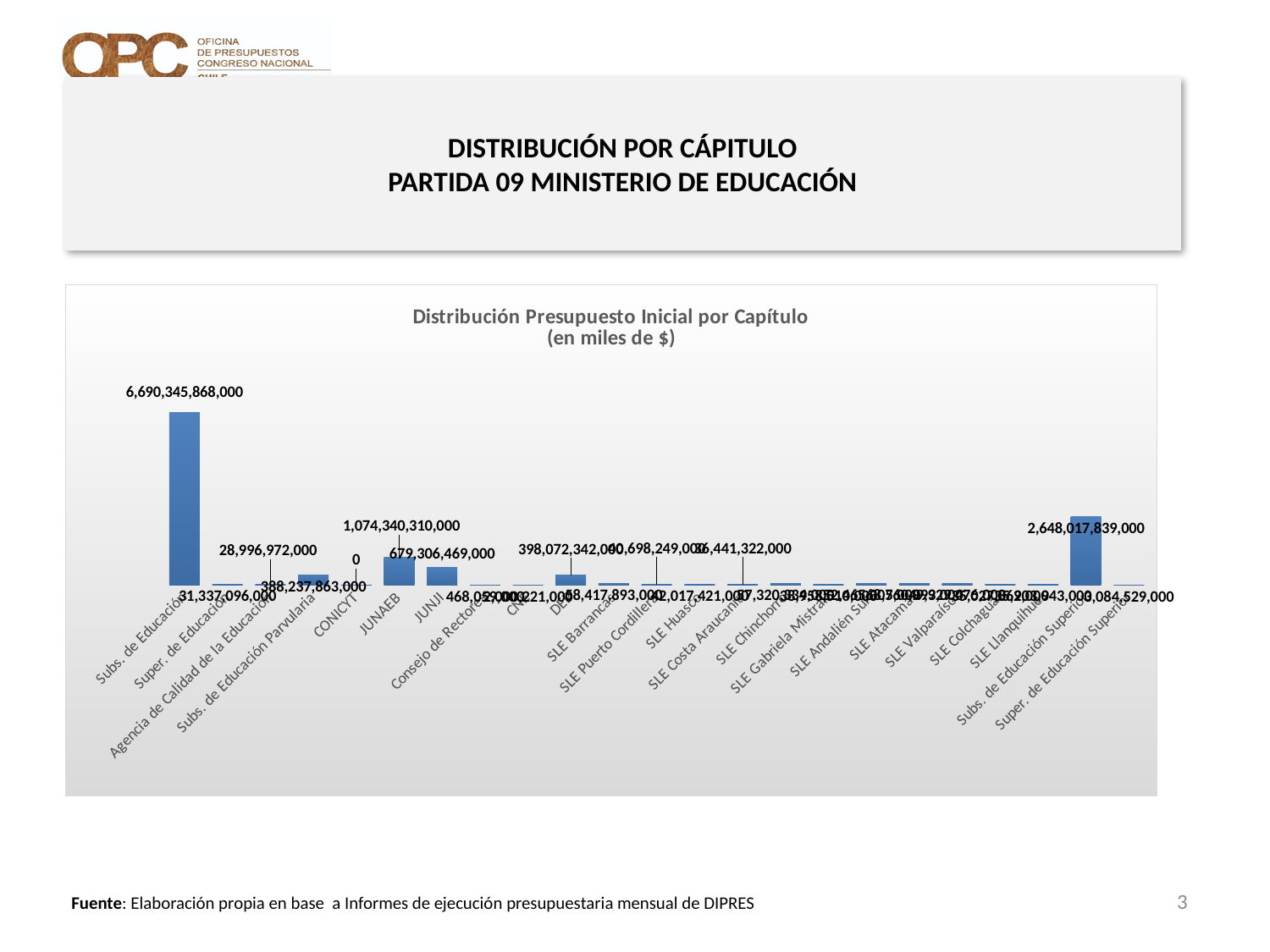
What kind of chart is shown on the slide? Bar chart What is the chart's title? Distribución Presupuesto Inicial por Capítulo (en miles de $) Which is larger, the value for JUNAEB or the value for JUNJI? JUNAEB What is the value for JUNAEB? 1,074,340,310,000 What is the value for JUNJI? 679,306,469,000 What is the value for Subs. de Educación Parvularia? 388,237,863,000 What is the value for CONICYT? 0 What is the difference between the values for JUNAEB and JUNJI? 395,033,841,000 What is the value for Subs. de Educación Superior? 2,648,017,839,000 What is the value for Subs. de Educación? 6,690,345,868,000 Which category has the lowest value? CONICYT Which category has the highest value? Subs. de Educación